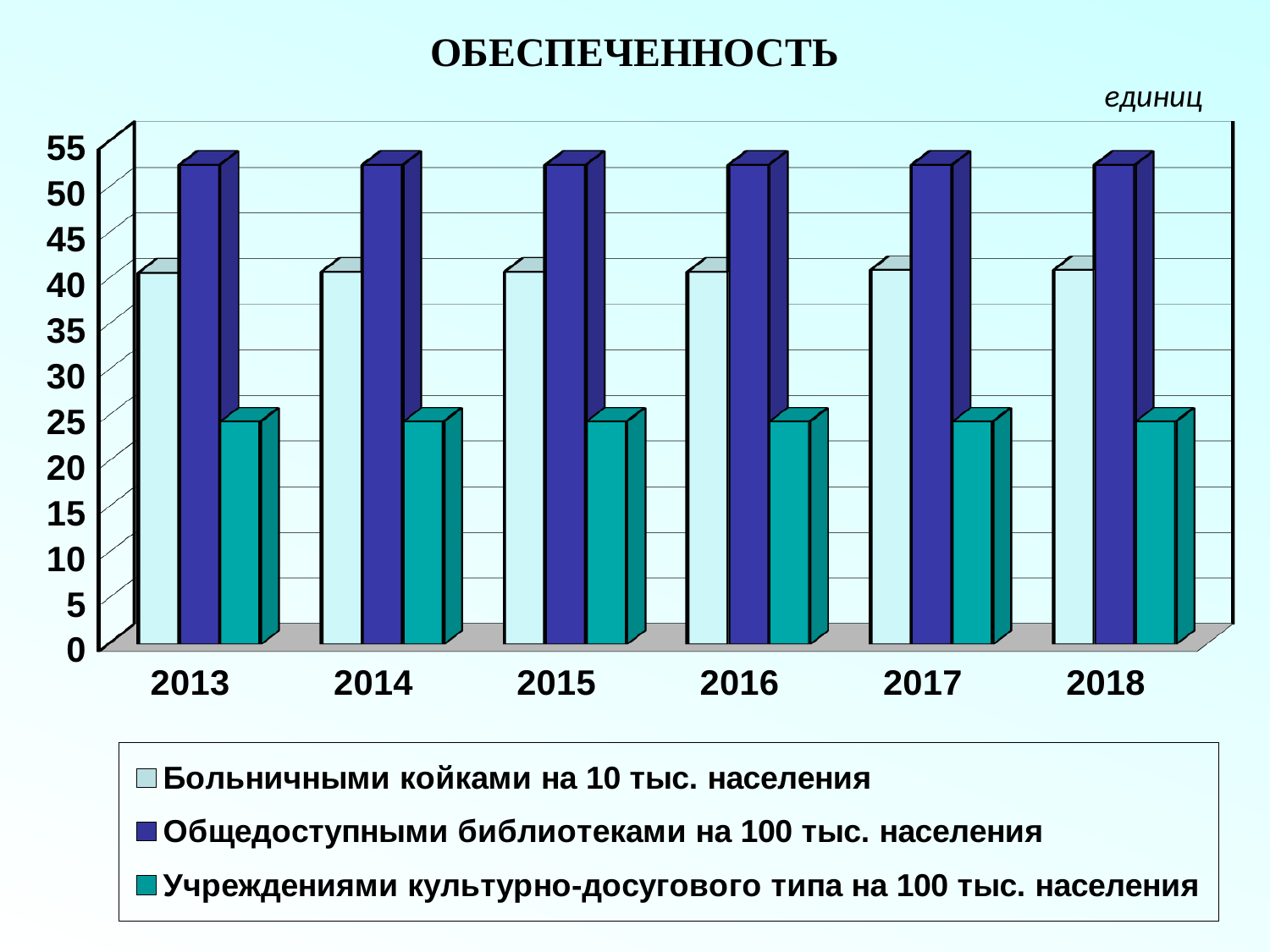
Do the values for Общедоступными библиотеками на 100 тыс. населения rise, fall or stay about the same from 2013 to 2018? stay about the same What is the title of the chart? ОБЕСПЕЧЕННОСТЬ In 2016, which is larger: the value for Больничными койками на 10 тыс. населения or the value for Учреждениями культурно-досугового типа на 100 тыс. населения? Больничными койками на 10 тыс. населения How many series does the legend list? 3 What kind of chart is shown on the slide? bar chart Is the value for Общедоступными библиотеками на 100 тыс. населения in 2015 greater or less than 50? greater How many years are shown on the x axis of the chart? 6 Which series has the highest value in 2013? Общедоступными библиотеками на 100 тыс. населения Which series has the lowest value in 2018? Учреждениями культурно-досугового типа на 100 тыс. населения Is the value for Больничными койками на 10 тыс. населения in 2014 greater or less than 35? greater What unit label is shown above the chart? единиц Is the value for Учреждениями культурно-досугового типа на 100 тыс. населения in 2017 greater or less than 20? greater